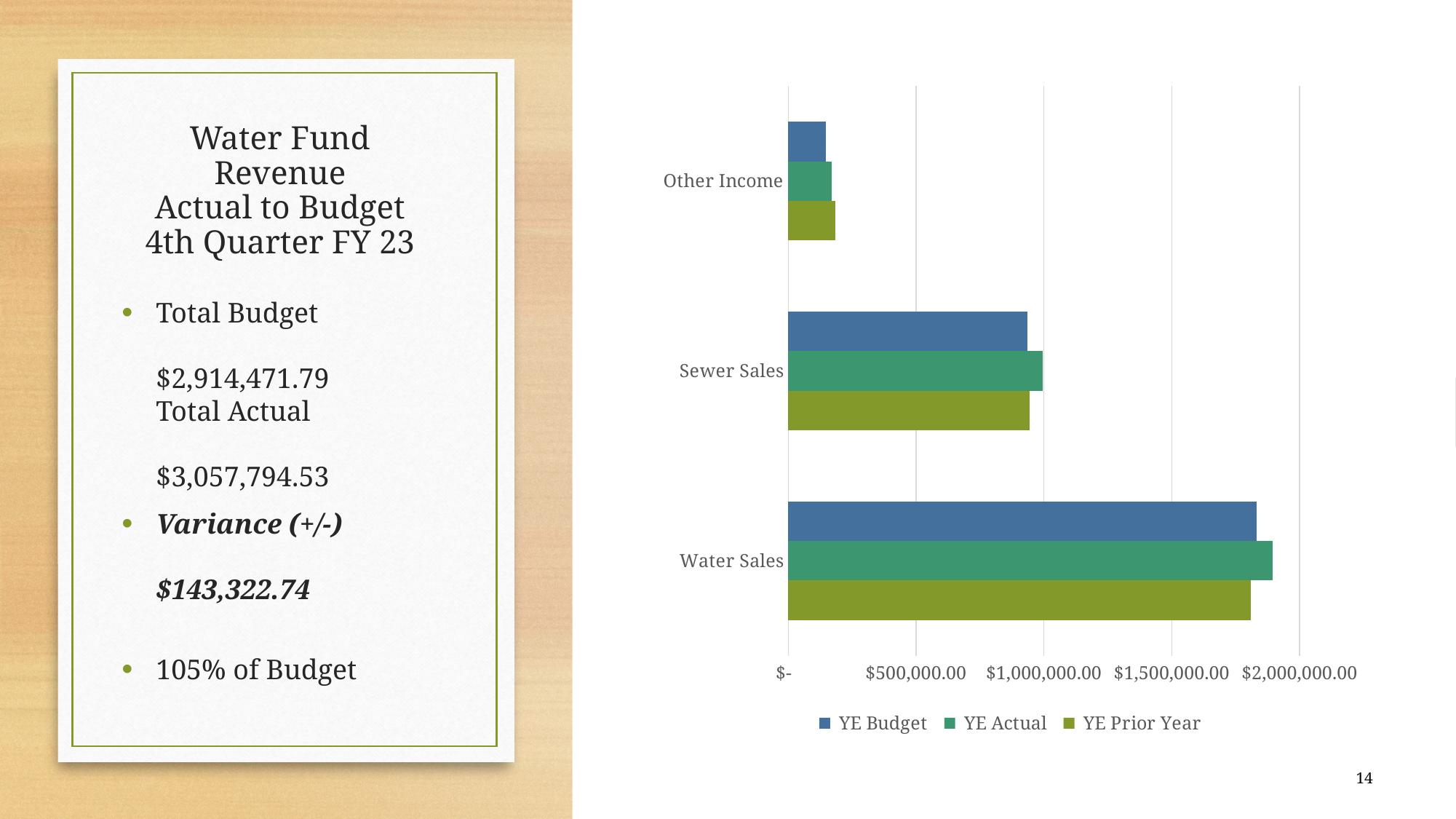
Which category has the lowest YE Budget value? Other Income Is the YE Actual value for Other Income greater or less than $500,000.00? less For Water Sales, which is larger: YE Actual or YE Prior Year? YE Actual How many categories are shown on the chart? 3 What is the last series listed in the chart legend? YE Prior Year Which category has the highest YE Actual value? Water Sales For Water Sales, which is larger: YE Actual or YE Budget? YE Actual How many series does the chart legend list? 3 Is the YE Prior Year value for Water Sales greater or less than $2,000,000.00? less Is the YE Budget value for Water Sales greater or less than $1,500,000.00? greater What kind of chart is shown on the slide? bar chart